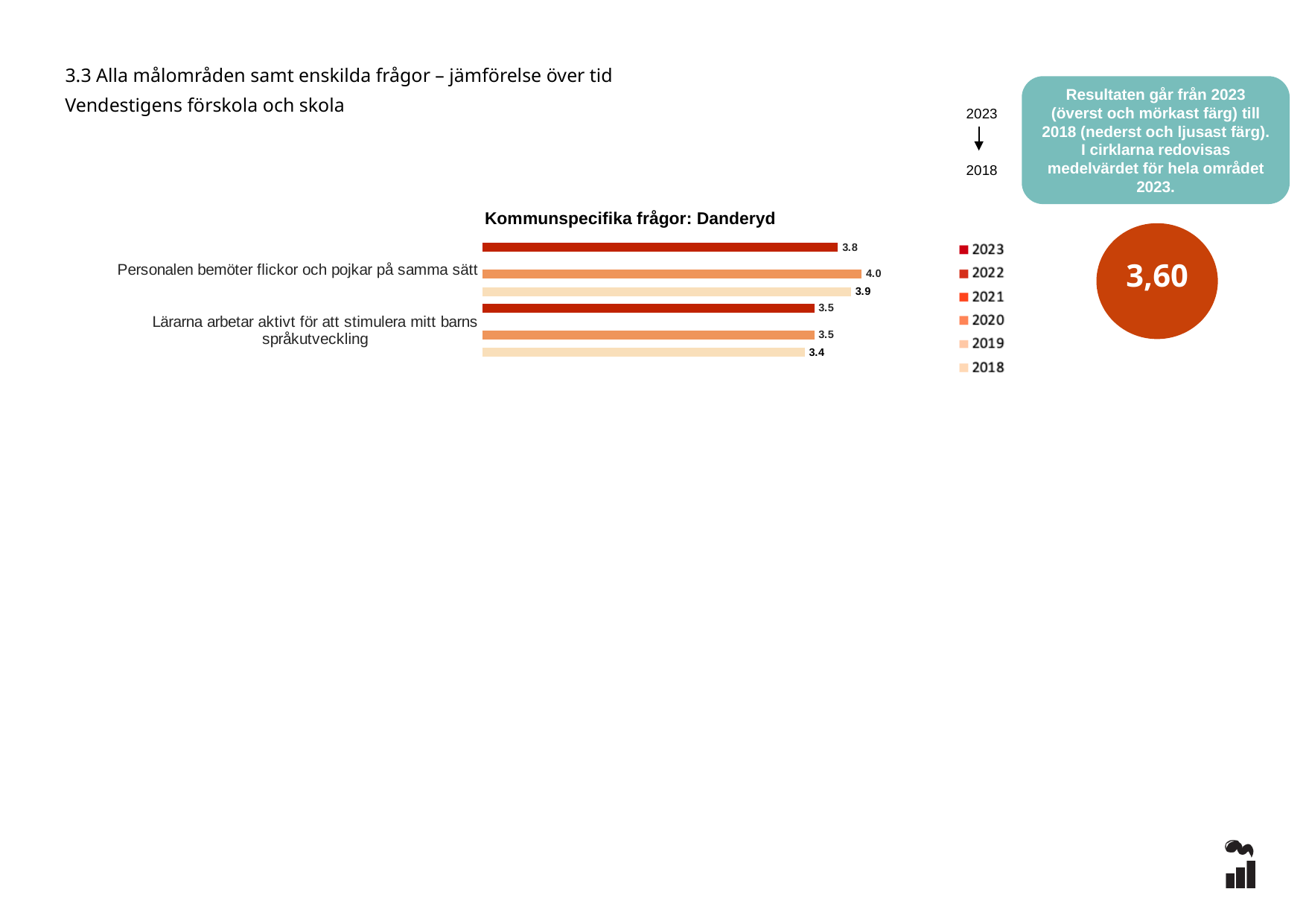
What is the 2023 value (top, darkest bar) for "Lärarna arbetar aktivt för att stimulera mitt barns språkutveckling"? 3.5 What is the 2018 value (bottom, lightest bar) for "Personalen bemöter flickor och pojkar på samma sätt"? 3.9 What type of chart is shown on the slide? Bar chart What is the title of the chart? Kommunspecifika frågor: Danderyd What is the 2018 value (bottom, lightest bar) for "Lärarna arbetar aktivt för att stimulera mitt barns språkutveckling"? 3.4 What is the highest value shown in the chart? 4.0 How many years does the legend list? 6 What is the lowest value shown in the chart? 3.4 What is the difference between the 2018 value and the 2023 value for "Personalen bemöter flickor och pojkar på samma sätt"? 0.1 Which question has the higher 2023 value: "Personalen bemöter flickor och pojkar på samma sätt" or "Lärarna arbetar aktivt för att stimulera mitt barns språkutveckling"? Personalen bemöter flickor och pojkar på samma sätt What is the 2023 value (top, darkest bar) for "Personalen bemöter flickor och pojkar på samma sätt"? 3.8 How many questions (categories) are shown in the chart? 2